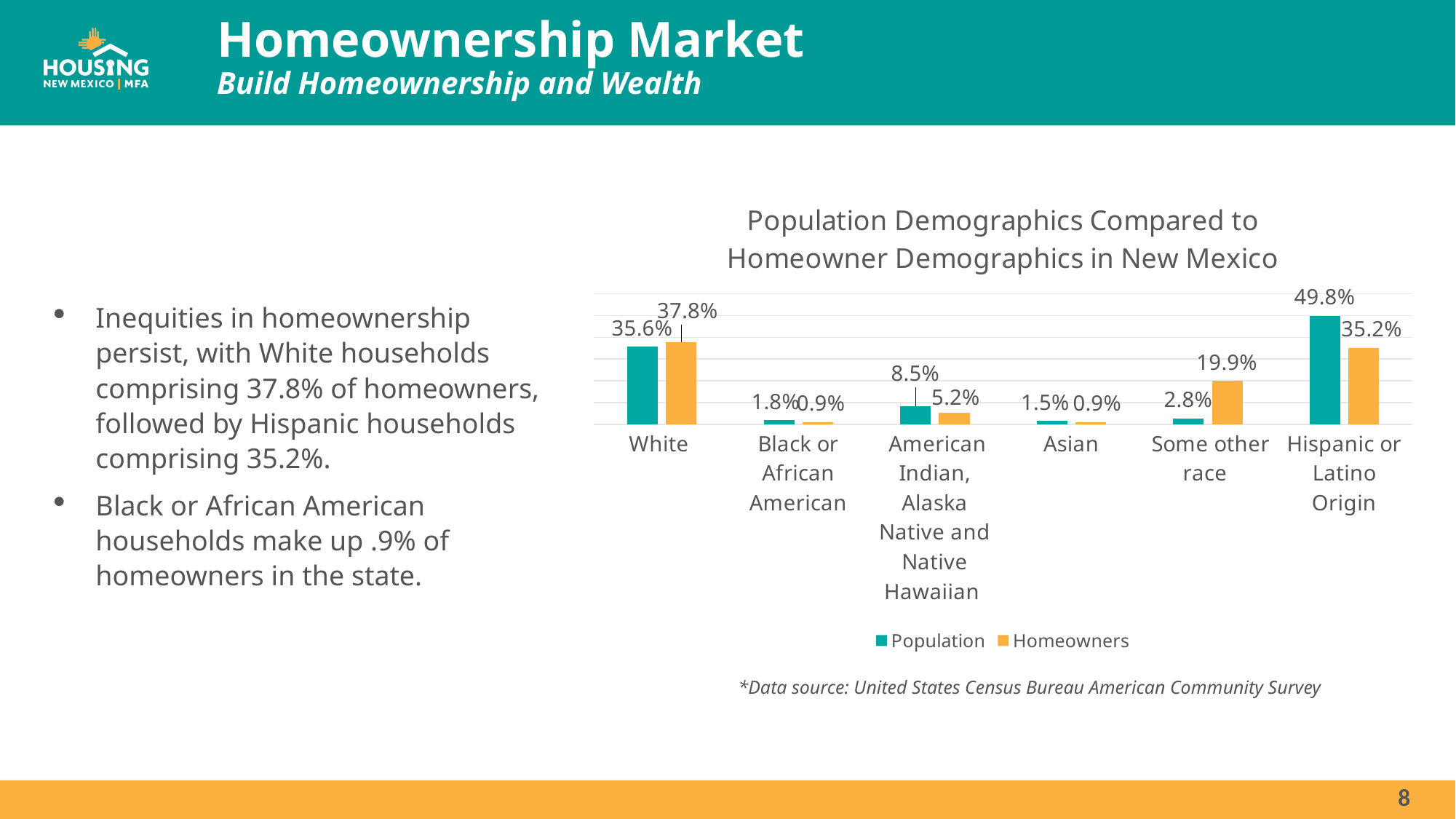
What is the difference between the Population and Homeowners values for Hispanic or Latino Origin? 14.6% What is the Homeowners value for White? 37.8% What is the difference between the Homeowners and Population values for Some other race? 17.1% Which category has the lowest Population value? Asian How many series does the legend list? 2 What is the Population value for American Indian, Alaska Native and Native Hawaiian? 8.5% For White, which is larger: the Population value or the Homeowners value? Homeowners What kind of chart is shown on the slide? Bar chart What is the Population value for Hispanic or Latino Origin? 49.8% How many categories are shown on the x axis? 6 What is the Homeowners value for Some other race? 19.9% Which category has the highest Population value? Hispanic or Latino Origin